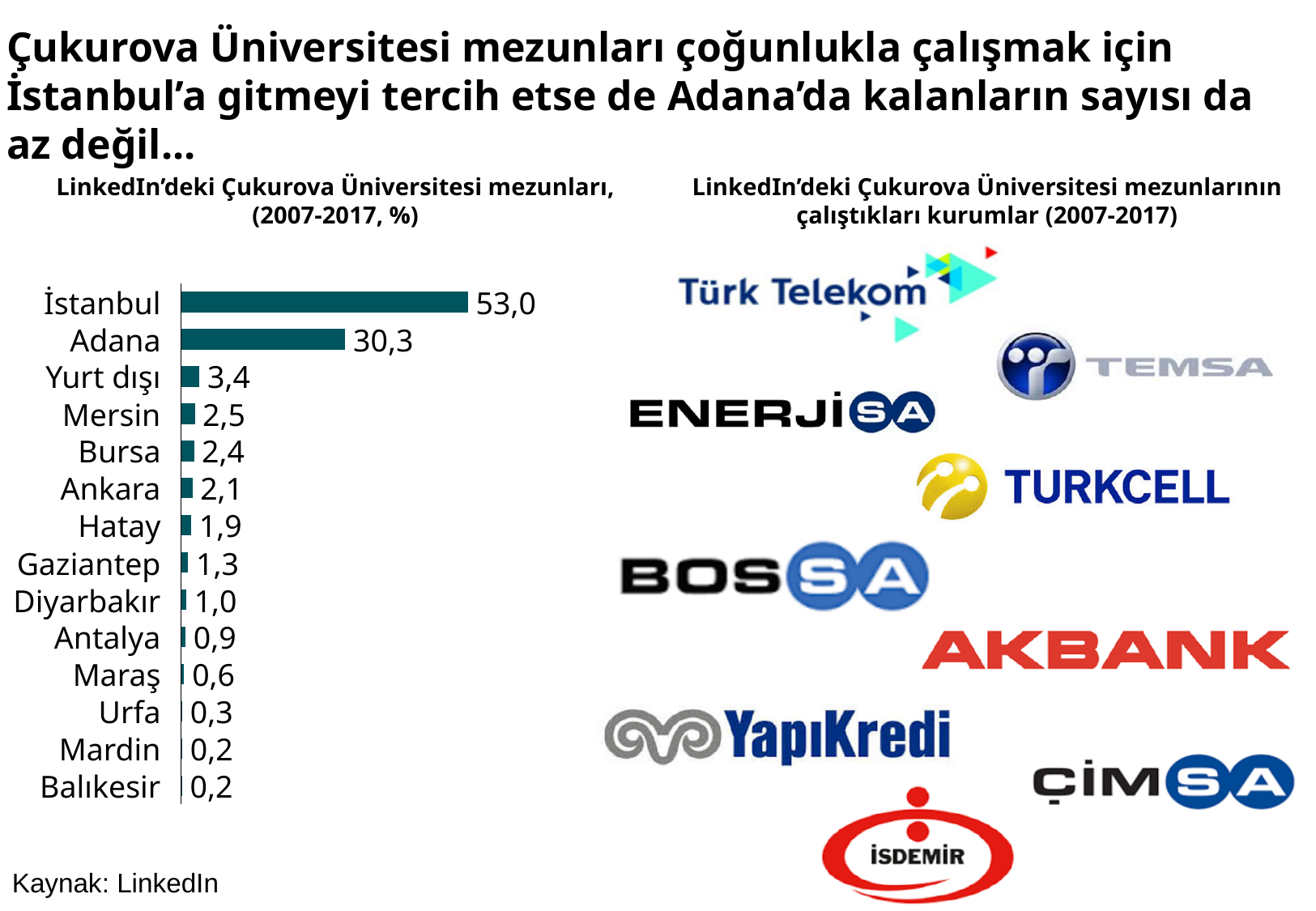
What is the value shown for Adana in the bar chart? 30,3 What type of chart is used to show the distribution of graduates by location? Bar chart Which has a larger value, Mersin or Ankara? Mersin Which has a larger value, Gaziantep or Antalya? Gaziantep What is the difference between the values for Adana and Yurt dışı? 26,9 What is the title of the bar chart on the left? LinkedIn'deki Çukurova Üniversitesi mezunları, (2007-2017, %) What is the value for Hatay in the chart? 1,9 Which city has the highest share of graduates in the chart? İstanbul What value does the chart show for Yurt dışı? 3,4 What percentage of LinkedIn Çukurova Üniversitesi graduates are in İstanbul? 53,0 What is the difference between the values for İstanbul and Adana? 22,7 How many categories are shown in the bar chart? 14